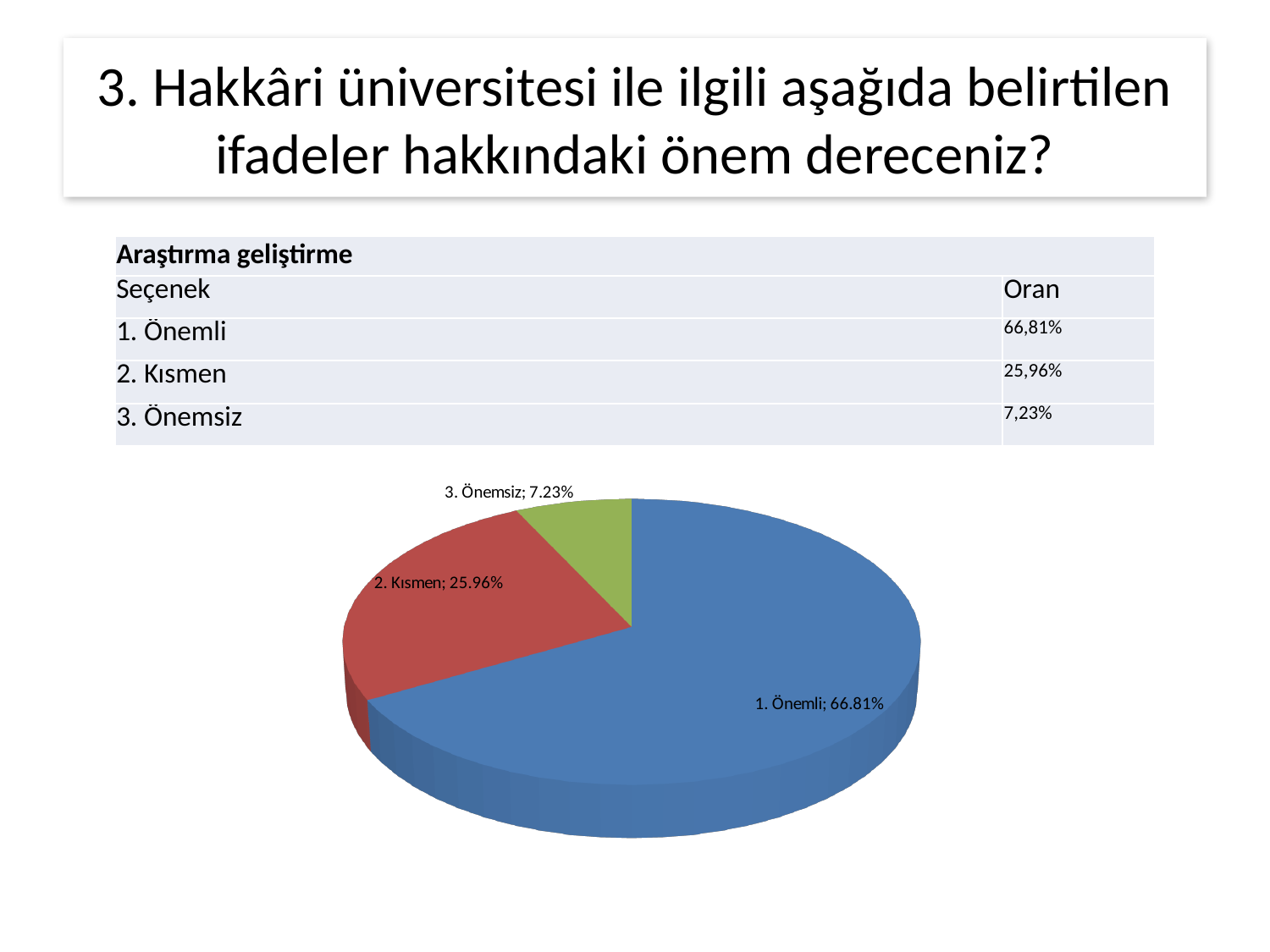
What colour is the slice for "1. Önemli" in the pie chart? blue Which category has the largest slice in the pie chart? 1. Önemli How many slices does the pie chart have? 3 What colour is the slice for "3. Önemsiz" in the pie chart? green Which is larger in the pie chart, "2. Kısmen" or "3. Önemsiz"? 2. Kısmen What is the difference between the values for "1. Önemli" and "2. Kısmen" in the pie chart? 40.85% What kind of chart is shown on the slide? pie chart What is the value shown for "2. Kısmen" in the pie chart? 25.96% Which category has the smallest slice in the pie chart? 3. Önemsiz What is the value shown for "3. Önemsiz" in the pie chart? 7.23% What is the value shown for "1. Önemli" in the pie chart? 66.81% What is the difference between the values for "2. Kısmen" and "3. Önemsiz" in the pie chart? 18.73%